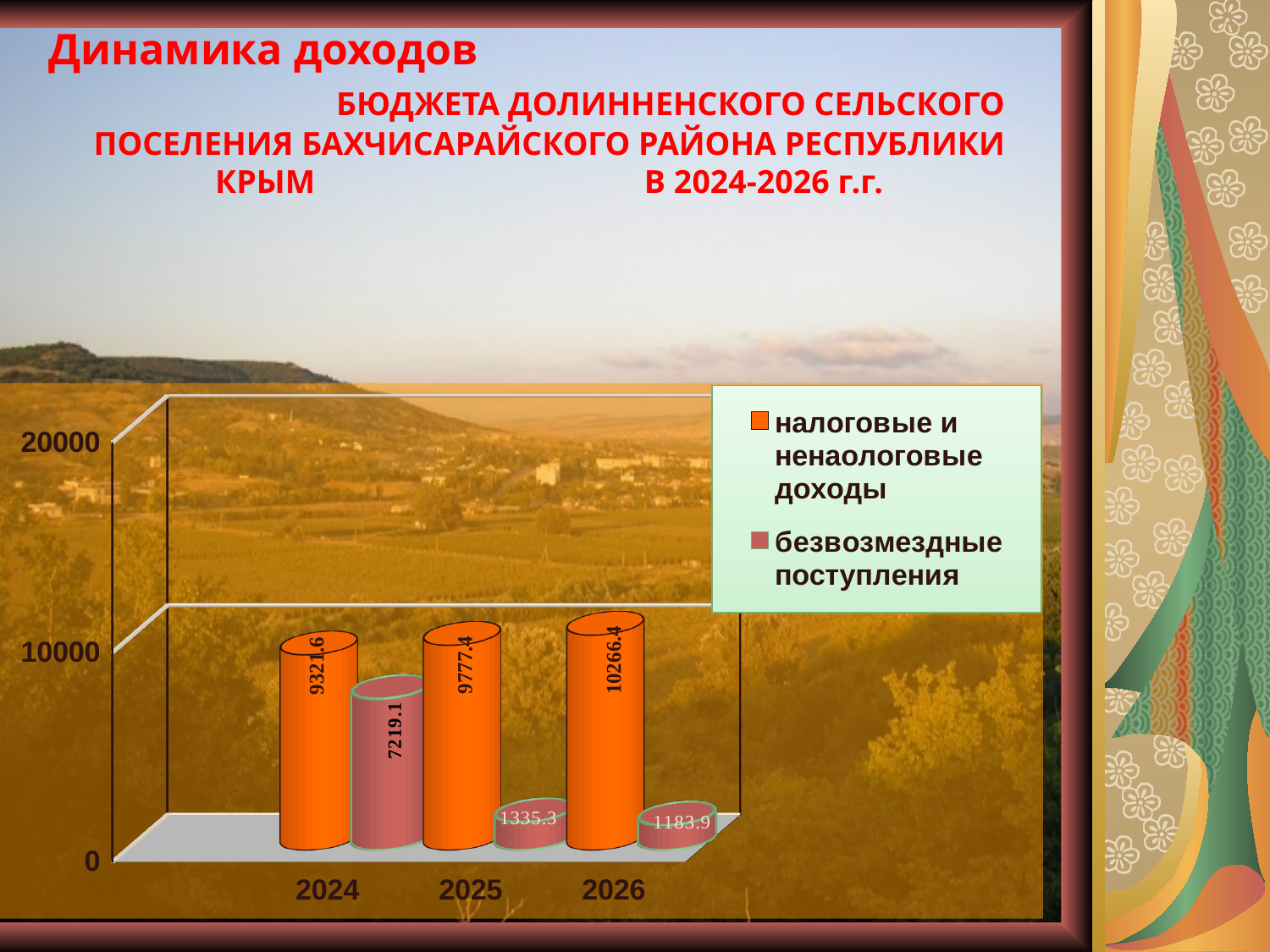
What is the value of безвозмездные поступления for 2026? 1183.9 In which year is безвозмездные поступления the lowest? 2026 What is the difference between налоговые и ненаологовые доходы and безвозмездные поступления in 2024? 2102.5 Does налоговые и ненаологовые доходы rise or fall from 2024 to 2026? rise In which year is налоговые и ненаологовые доходы the highest? 2026 Is the value of налоговые и ненаологовые доходы for 2026 greater or less than 10000? greater How many series does the legend list? 2 Which is larger in 2025: налоговые и ненаологовые доходы or безвозмездные поступления? налоговые и ненаологовые доходы What is the value of налоговые и ненаологовые доходы for 2026? 10266.4 What is the value of безвозмездные поступления for 2025? 1335.3 How many years are shown on the x axis? 3 What is the value of налоговые и ненаологовые доходы for 2024? 9321.6